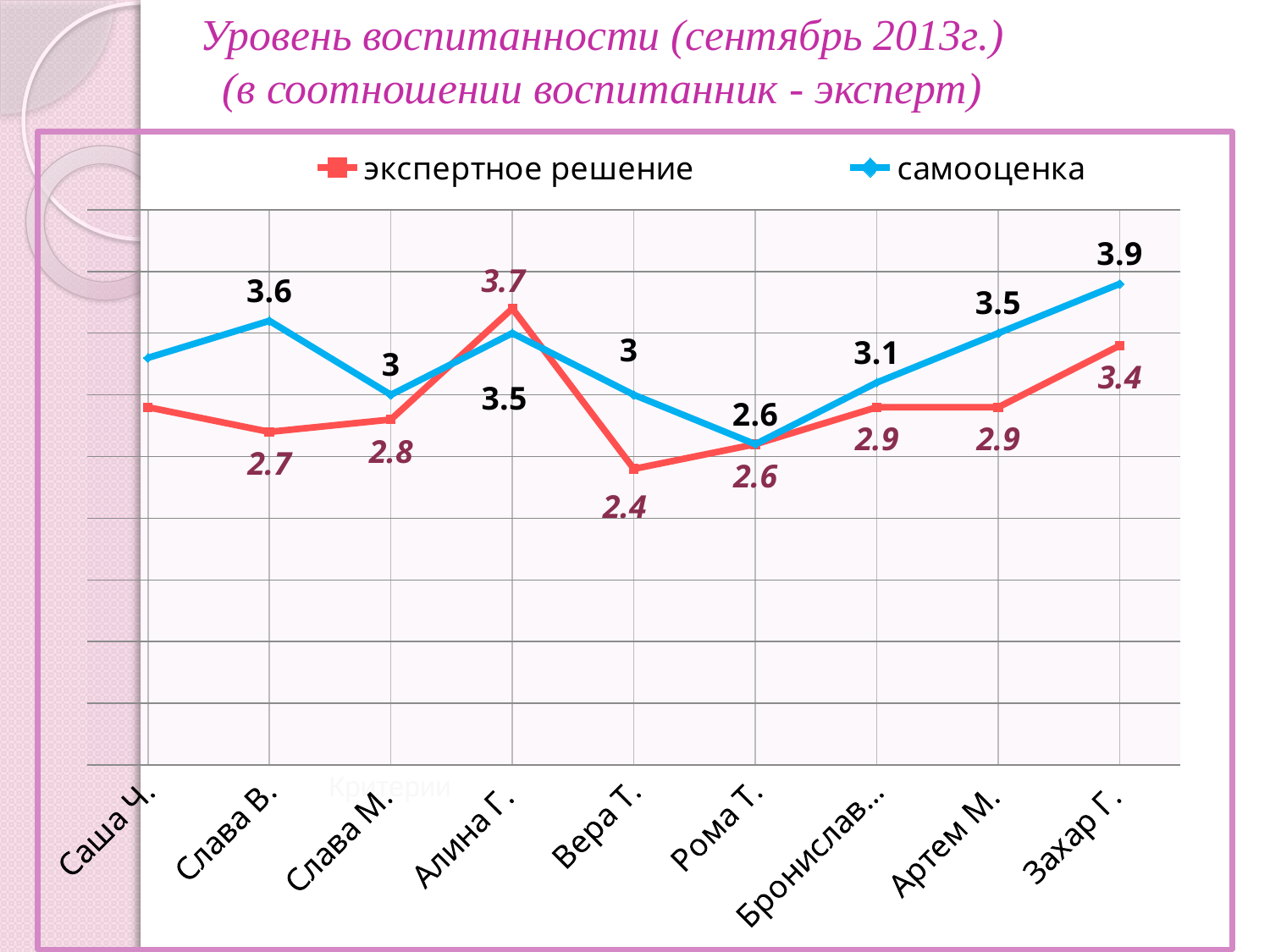
How many categories (names) are shown on the x axis? 9 What kind of chart is shown on the slide? line chart What is the difference between самооценка and экспертное решение for Слава В.? 0.9 For Алина Г., which is larger: экспертное решение or самооценка? экспертное решение Which name has the lowest экспертное решение value? Вера Т. What is the экспертное решение value for Алина Г.? 3.7 What is the экспертное решение value for Вера Т.? 2.4 Which colour is used for the самооценка series? blue How many series does the legend list? 2 Which name has the highest самооценка value? Захар Г. What is the самооценка value for Захар Г.? 3.9 Does the самооценка line rise or fall from Рома Т. to Захар Г.? rise